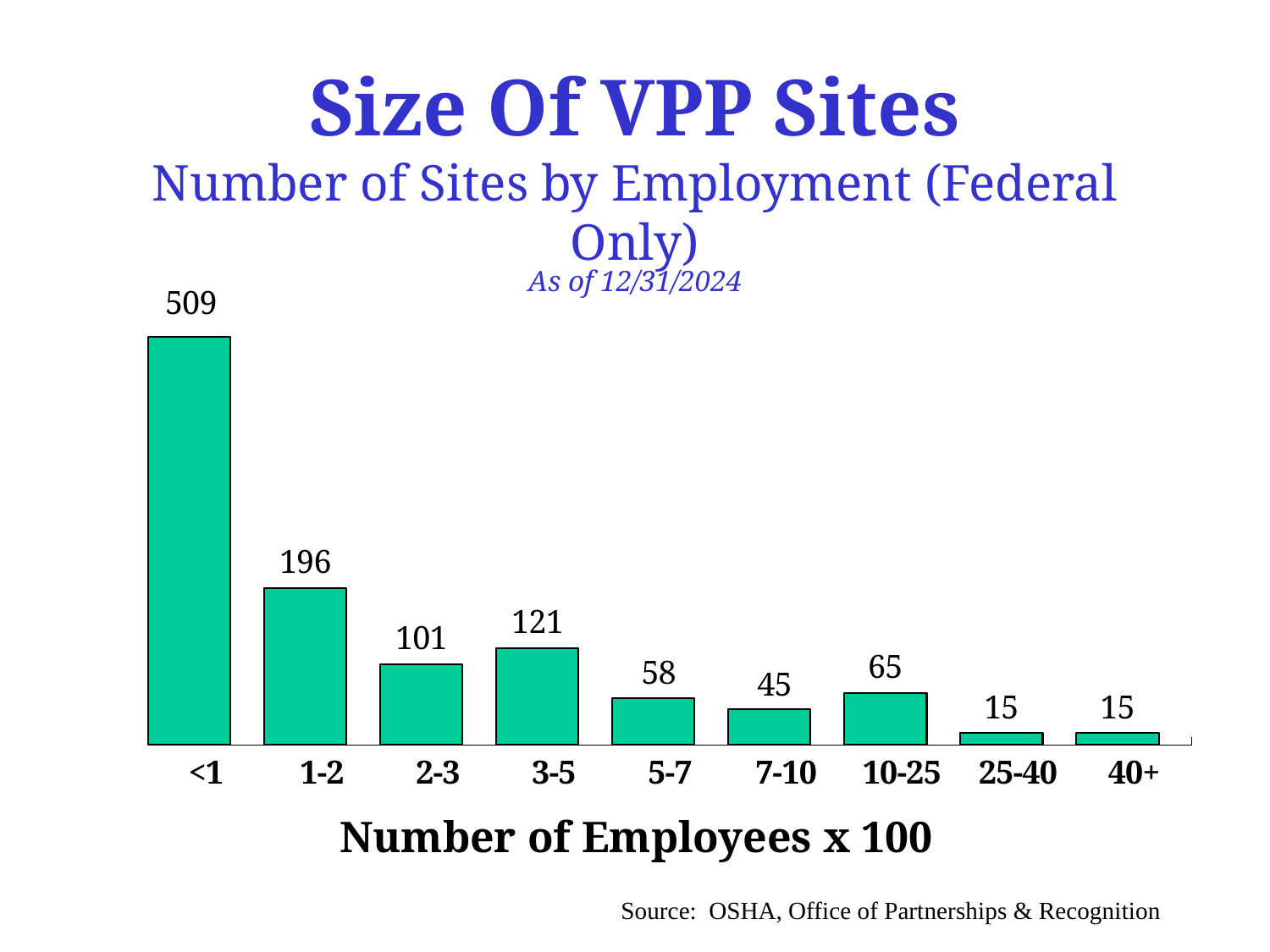
What is the label of the x axis? Number of Employees x 100 What is the difference between the number of sites in the <1 category and the 1-2 category? 313 How many employment categories are shown on the x axis? 9 What is the 'as of' date shown under the chart title? 12/31/2024 What kind of chart is shown on the slide? Bar chart How many sites are in the <1 employment category? 509 Which employment category has the highest number of sites? <1 Which has more sites, the 5-7 category or the 7-10 category? 5-7 What is the difference between the 3-5 category and the 2-3 category? 20 Which categories have the lowest number of sites? 25-40 and 40+ What is the number of sites for the 3-5 category? 121 What is the value shown for the 10-25 category? 65